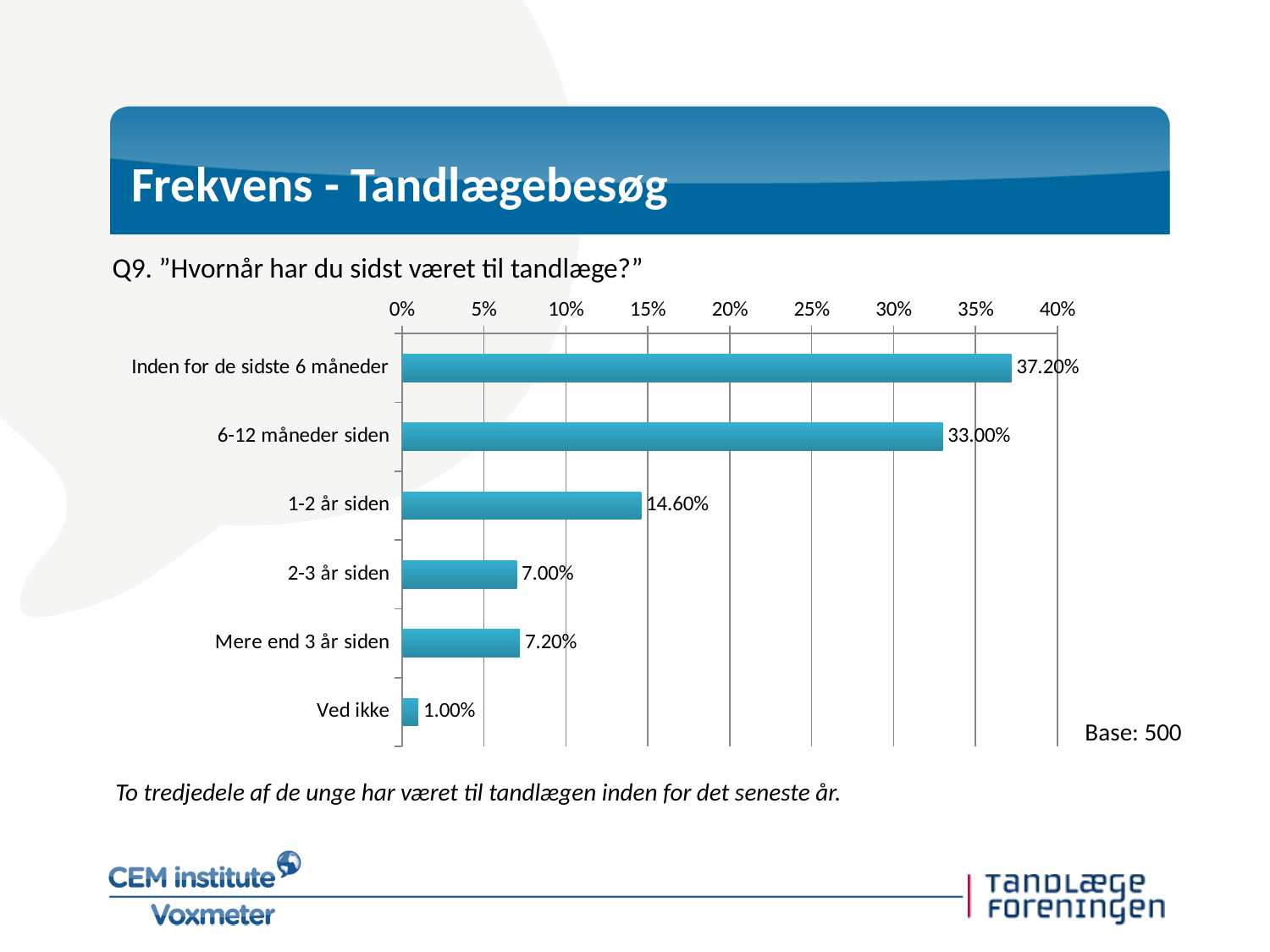
What is the value for "6-12 måneder siden"? 33.00% Which category has the highest value? Inden for de sidste 6 måneder What is the difference between "Inden for de sidste 6 måneder" and "6-12 måneder siden"? 4.20% What is the base (number of respondents) shown next to the chart? 500 How many categories are shown in the chart? 6 Which category has the lowest value? Ved ikke What is the value for "Inden for de sidste 6 måneder"? 37.20% What kind of chart is shown on the slide? bar chart Is the value for "1-2 år siden" greater or less than 15%? less Which is larger, "2-3 år siden" or "Mere end 3 år siden"? Mere end 3 år siden What is the value for "1-2 år siden"? 14.60% What is the value for "Ved ikke"? 1.00%